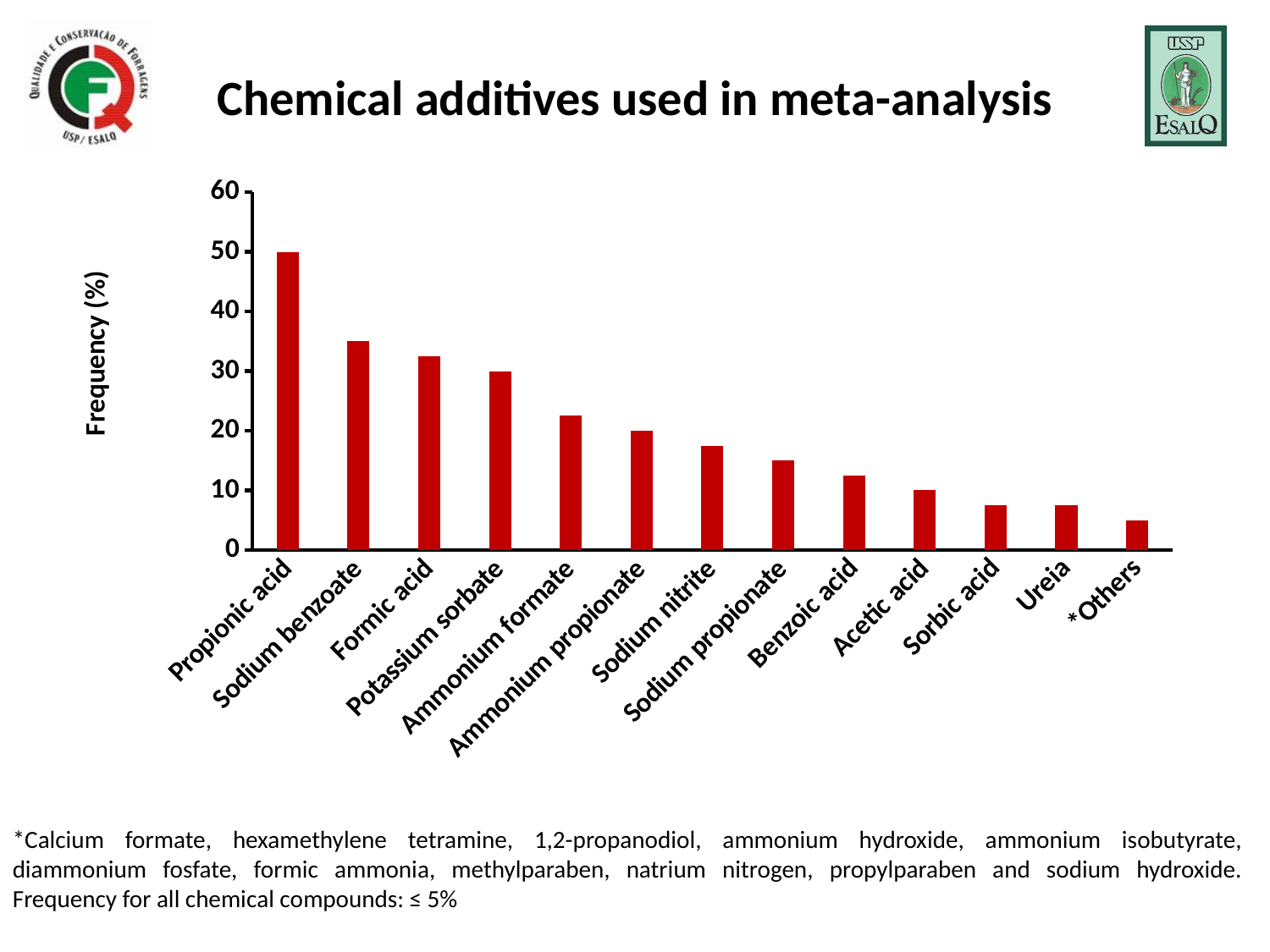
What type of chart is shown on the slide? bar chart Which category has the lowest frequency? *Others What is the frequency (%) for Propionic acid? 50 Is the value for Sodium benzoate greater or less than 30? greater How many categories are shown on the x axis? 13 What is the label of the y axis? Frequency (%) Which has a higher frequency, Formic acid or Sodium propionate? Formic acid Is the value for Ammonium formate greater or less than 30? less Which chemical additive has the highest frequency? Propionic acid Is the value for Sodium nitrite greater or less than 20? less Do the values rise or fall moving from left to right along the x axis? fall What is the frequency (%) for Acetic acid? 10